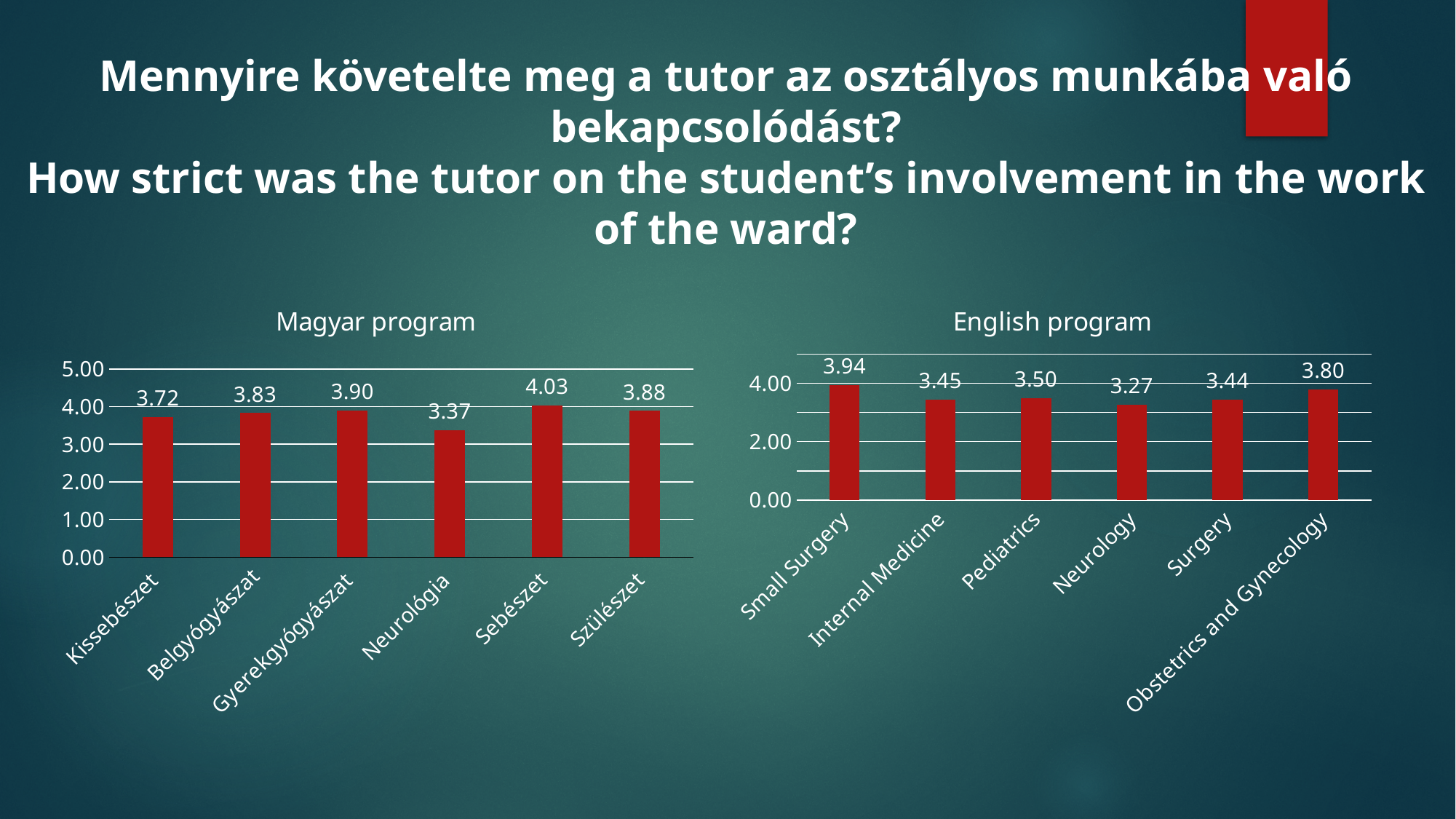
In the English program chart, which category has the lowest value? Neurology In the Magyar program chart, what is the difference between the values for Sebészet and Neurológia? 0.66 In the Magyar program chart, is the value for Sebészet greater or less than 4.00? greater In the English program chart, which category has the highest value? Small Surgery What kind of chart is the Magyar program chart? bar chart How many categories are shown in the English program chart? 6 In the English program chart, what is the value for Obstetrics and Gynecology? 3.80 In the Magyar program chart, which category has the highest value? Sebészet In the English program chart, which is larger: the value for Pediatrics or the value for Neurology? Pediatrics In the English program chart, what is the difference between the values for Small Surgery and Internal Medicine? 0.49 In the Magyar program chart, what is the value for Neurológia? 3.37 What is the title of the chart on the right side of the slide? English program